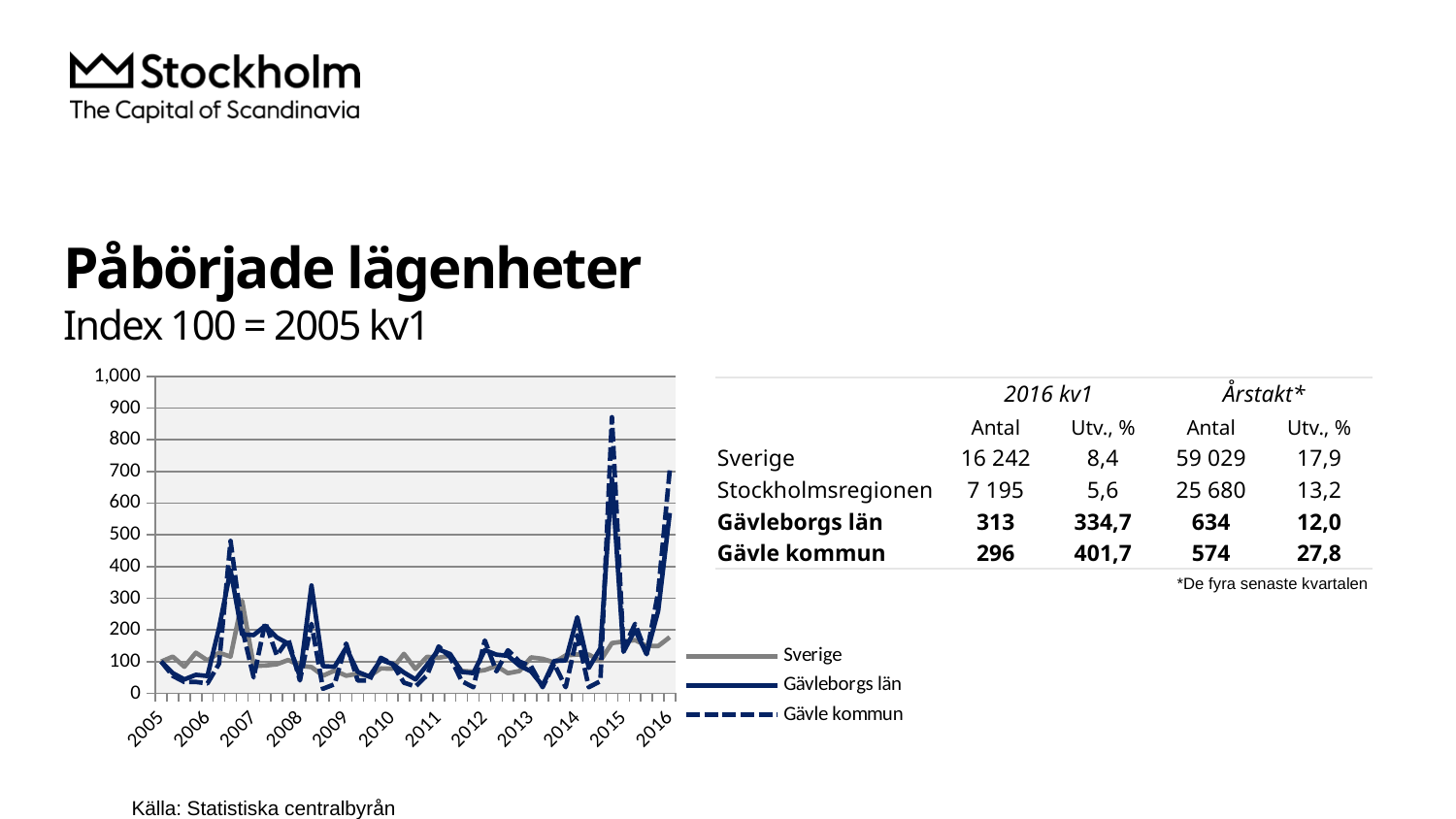
Which series are listed in the chart legend? Sverige, Gävleborgs län, Gävle kommun What is the index value for all series at 2005 kv1, according to the chart subtitle? 100 Which series has the higher value at the end of the chart in 2016, Sverige or Gävleborgs län? Gävleborgs län Which series reaches the highest peak in the chart? Gävle kommun How many year labels are shown on the x axis of the chart? 12 How many series does the chart legend list? 3 What type of chart is shown on the slide? Line chart What is the highest value shown on the y axis of the chart? 1,000 Is the peak value for Gävle kommun around 2015 greater or less than 800? greater Is the value for Gävleborgs län at the end of the series in 2016 greater or less than 600? less What is the title of the chart on the slide? Påbörjade lägenheter